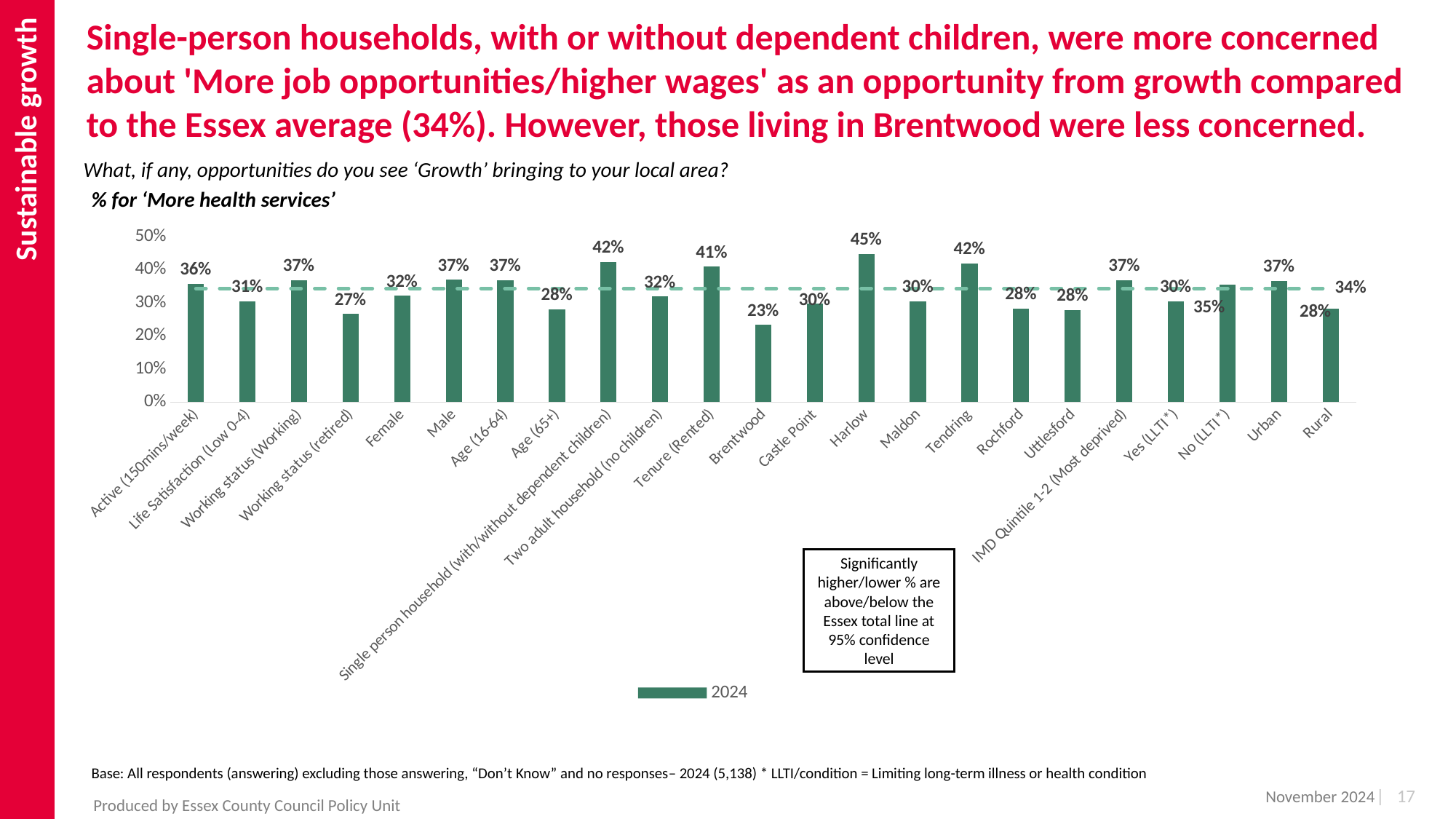
How many categories are shown on the x axis? 23 What is the value for Tenure (Rented)? 41% How many series does the legend list? 1 What kind of chart is shown? Bar chart Which category has the highest value? Harlow Which category has the lowest value? Brentwood What is the difference between the values for Harlow and Brentwood? 22% What is the value for Single person household (with/without dependent children)? 42% What value does the dashed Essex total line mark? 34% What is the value for Harlow? 45% What is the value for Brentwood? 23% Which is larger, the value for Female or the value for Male? Male